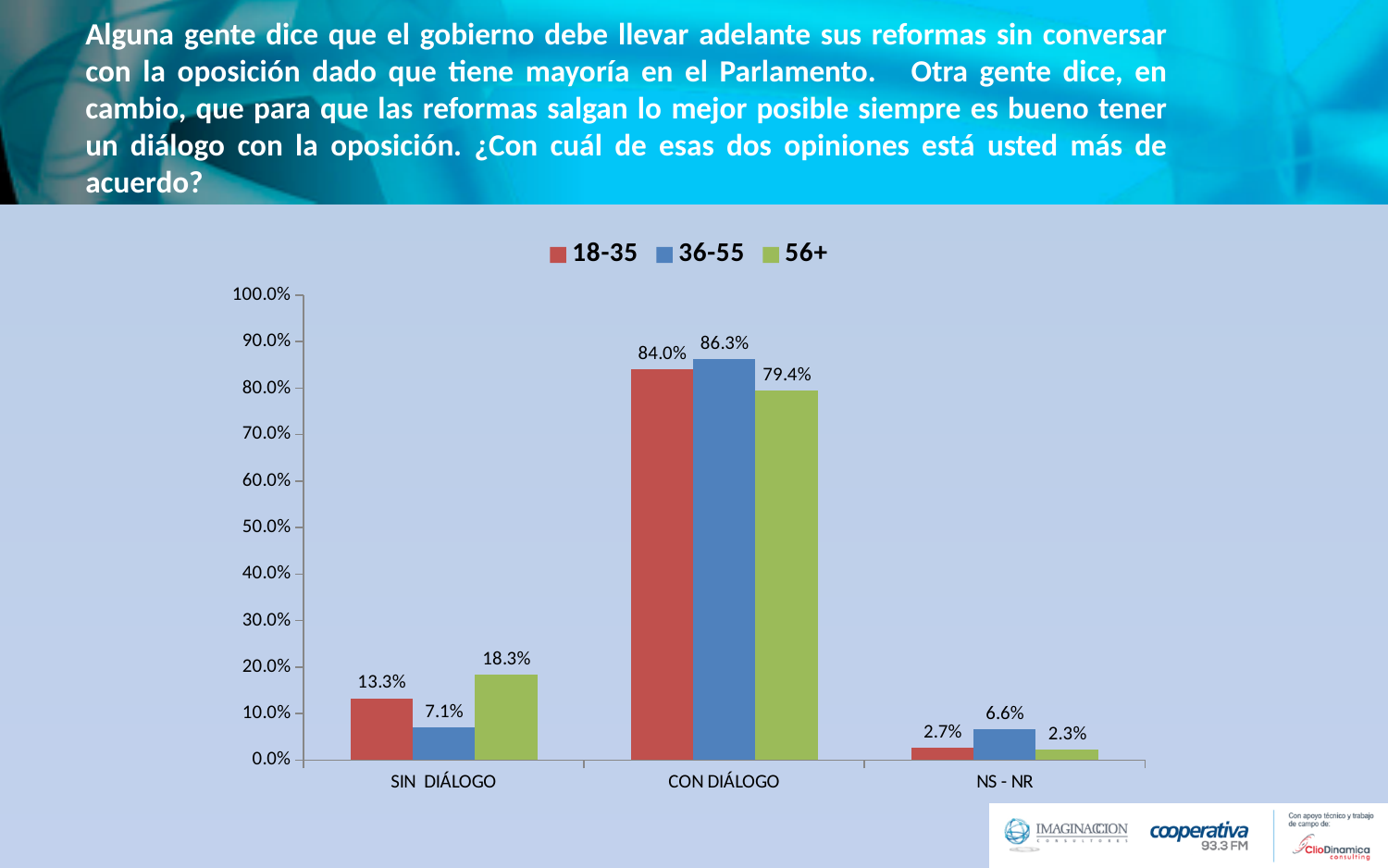
Is the value for the 56+ series in CON DIÁLOGO greater or less than 70.0%? greater Which age group has the highest value in the CON DIÁLOGO category? 36-55 What is the value for the 36-55 series in the NS - NR category? 6.6% How many series does the legend list? 3 Which colour represents the 56+ series in the legend? green What is the value for the 18-35 series in the CON DIÁLOGO category? 84.0% What is the difference between the 36-55 and 56+ values in the CON DIÁLOGO category? 6.9% What kind of chart is shown on the slide? bar chart Which age group has the lowest value in the SIN DIÁLOGO category? 36-55 Which is larger: the 18-35 value for SIN DIÁLOGO or the 56+ value for SIN DIÁLOGO? 56+ How many categories are shown on the x axis? 3 What is the value for the 56+ series in the SIN DIÁLOGO category? 18.3%